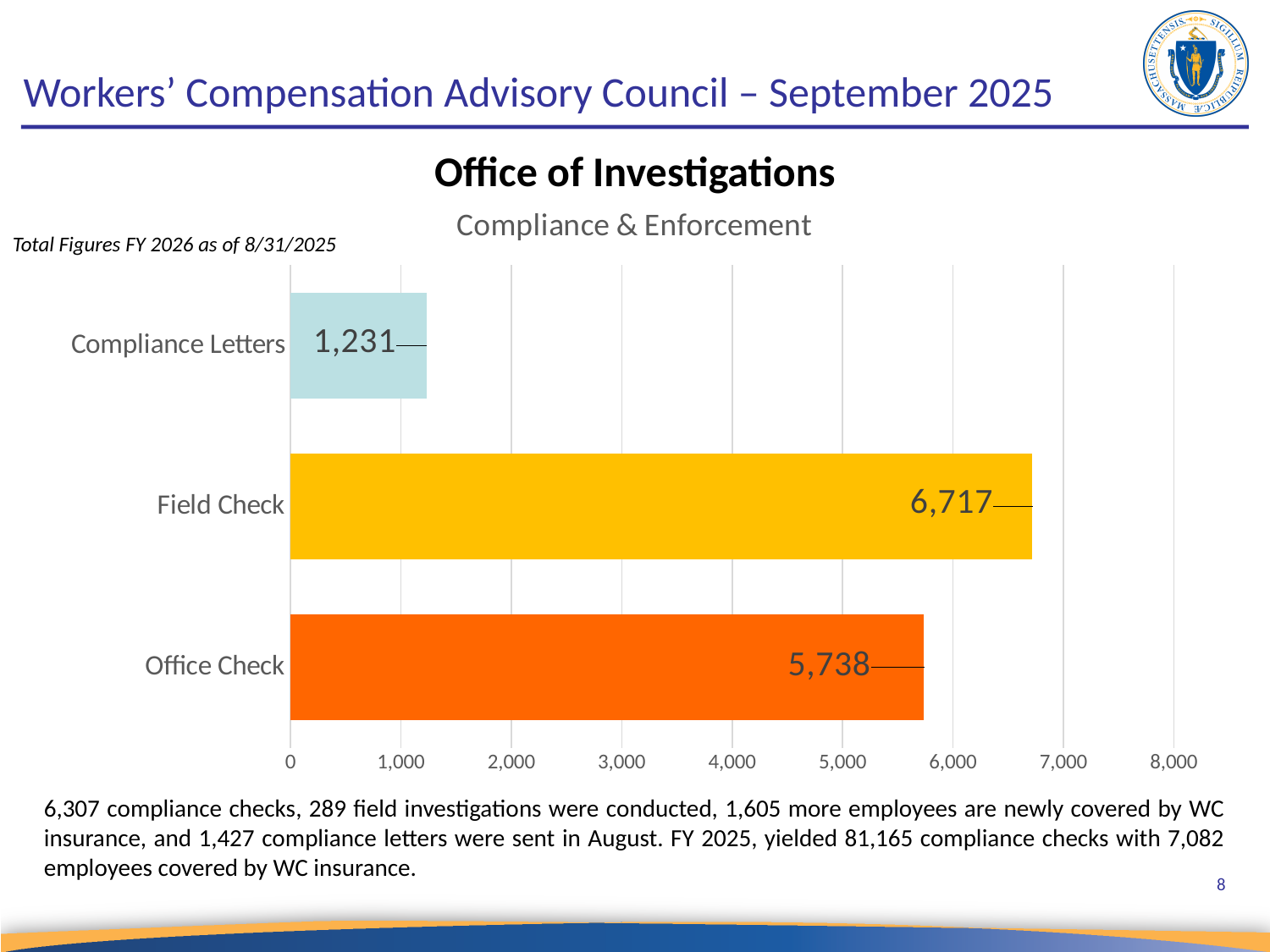
What is the difference between the Office Check and Compliance Letters values? 4,507 What is the value for Compliance Letters? 1,231 What kind of chart is shown on the slide? Bar chart What is the difference between the Field Check and Office Check values? 979 What is the title of the chart? Compliance & Enforcement Which is larger, the value for Office Check or the value for Compliance Letters? Office Check Which category has the lowest value? Compliance Letters Is the value for Field Check greater or less than 6,000? greater How many categories are shown in the chart? 3 What is the value for Field Check? 6,717 What is the value for Office Check? 5,738 Which category has the highest value? Field Check